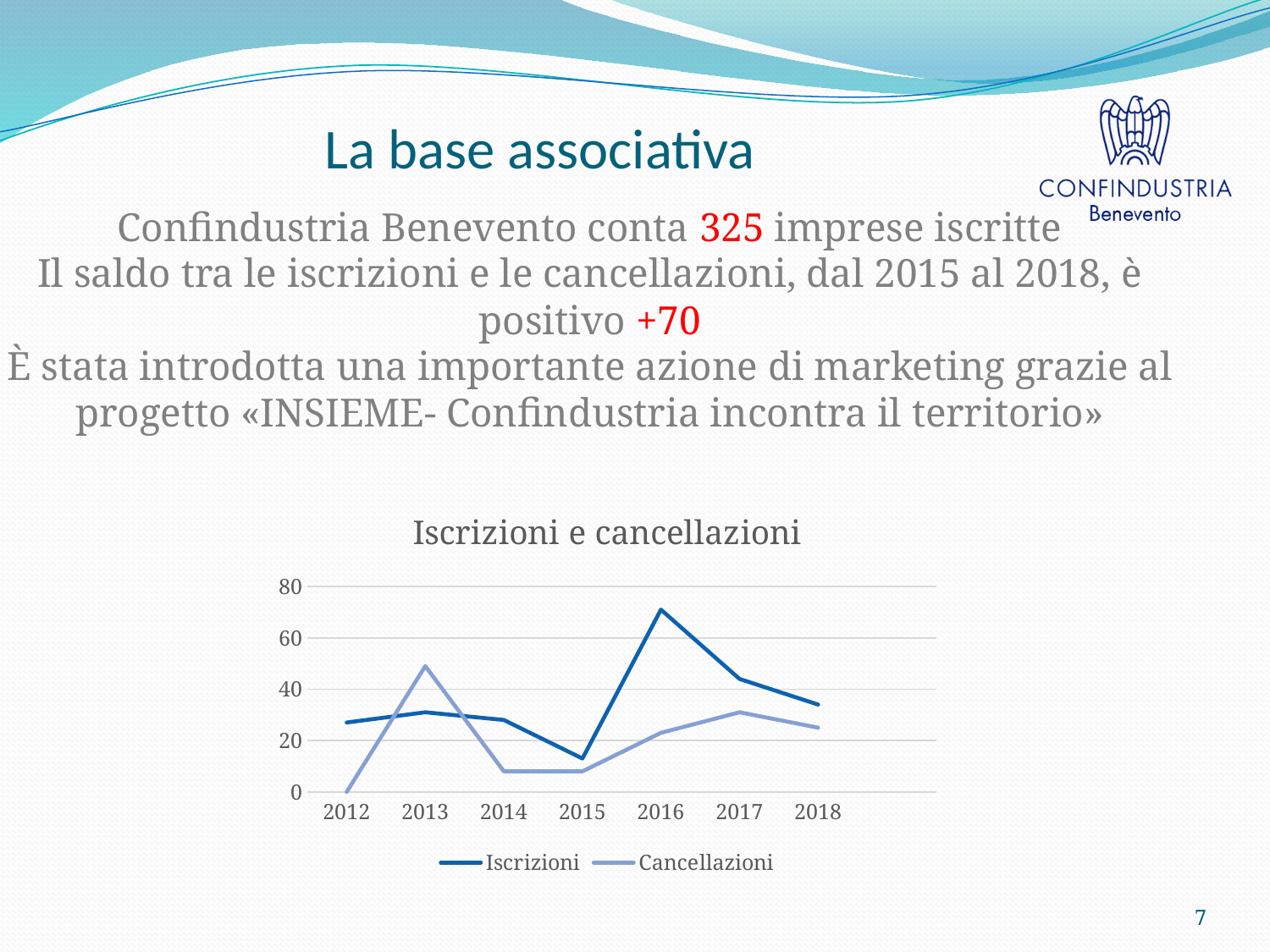
How many years are plotted along the x axis of the chart? 7 In 2013, which series has the larger value, Iscrizioni or Cancellazioni? Cancellazioni Which series is drawn with the darker blue line? Iscrizioni How many series does the chart legend list? 2 In which year does the Cancellazioni series reach its highest value? 2013 What kind of chart is shown on the slide? Line chart Is the value for Cancellazioni in 2014 greater or less than 20? less Does the Iscrizioni series rise or fall from 2016 to 2018? Fall What is the title of the chart? Iscrizioni e cancellazioni In which year does the Iscrizioni series reach its highest value? 2016 In which year does the Iscrizioni series reach its lowest value? 2015 Is the value for Iscrizioni in 2016 greater or less than 60? greater